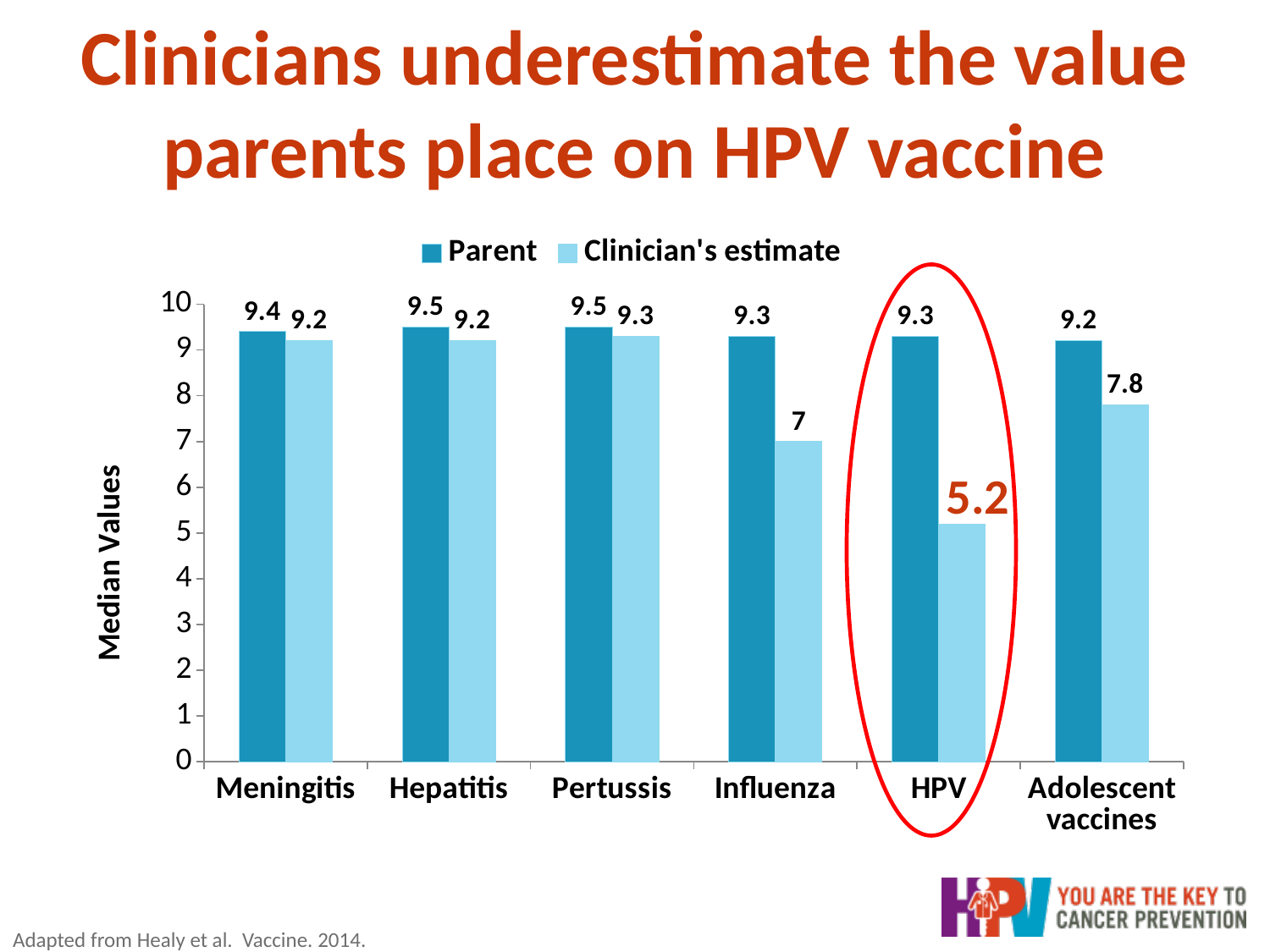
What kind of chart is shown on the slide? bar chart Which is larger for Adolescent vaccines, the Parent value or the Clinician's estimate? Parent What is the difference between the Parent value and the Clinician's estimate for HPV? 4.1 What is the Parent value for Influenza? 9.3 What is the Parent value for Meningitis? 9.4 Is the Clinician's estimate for Influenza greater or less than 8? less How many categories are shown on the x axis? 6 What is the difference between the Parent value and the Clinician's estimate for Influenza? 2.3 What is the Clinician's estimate for HPV? 5.2 How many series does the legend list? 2 What is the Clinician's estimate for Adolescent vaccines? 7.8 Which category has the lowest Clinician's estimate? HPV